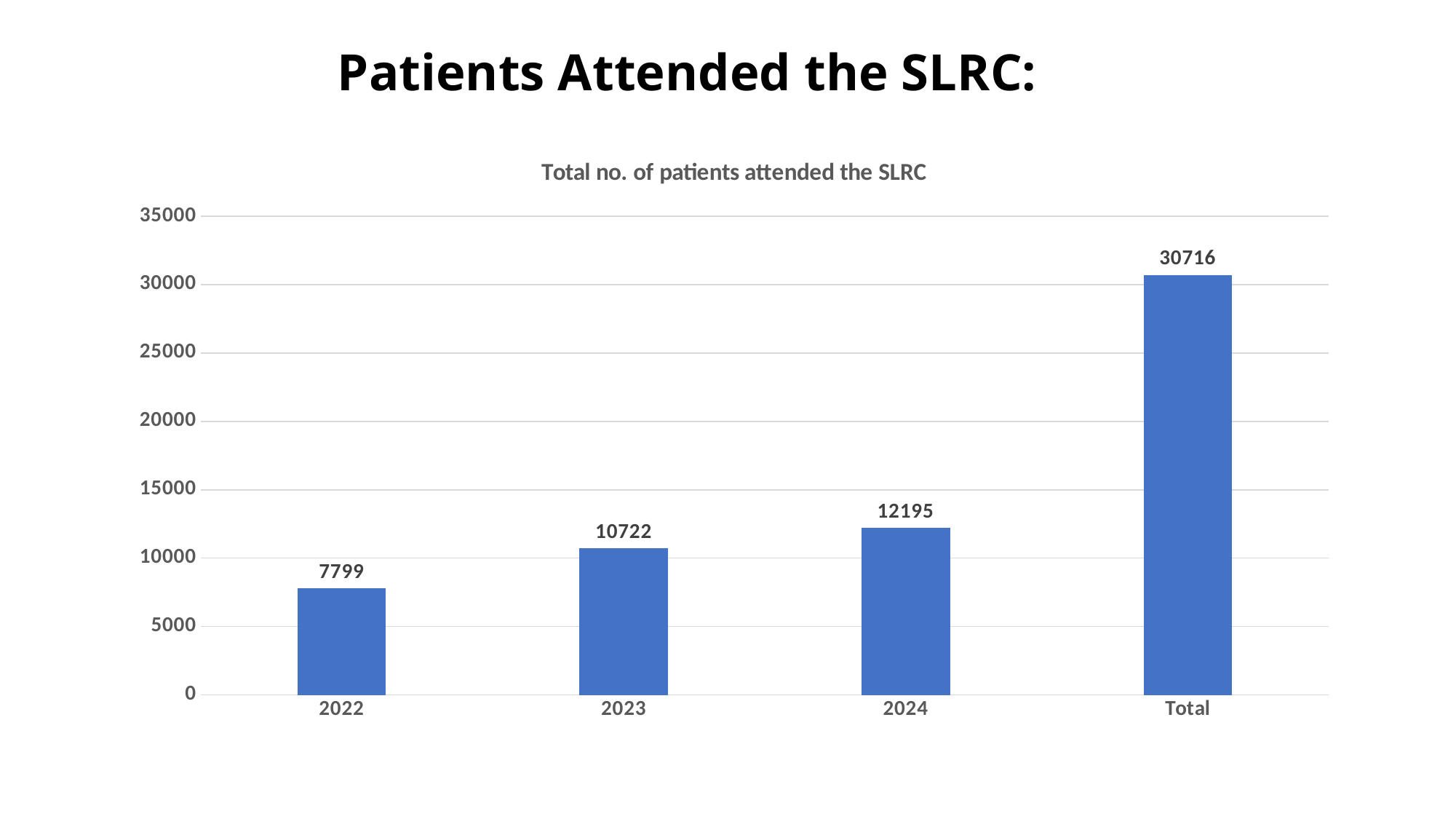
What kind of chart is this? bar chart How many categories are shown on the x axis? 4 Which category has the highest value? Total What is the difference between the values for 2024 and 2022? 4396 What is the value for 2022? 7799 What is the value for 2024? 12195 Do the values rise or fall from 2022 to 2024? rise What is the difference between the values for 2023 and 2022? 2923 What is the value for the Total bar? 30716 Which is larger, the value for 2023 or the value for 2024? 2024 What is the value for 2023? 10722 Which category has the lowest value? 2022